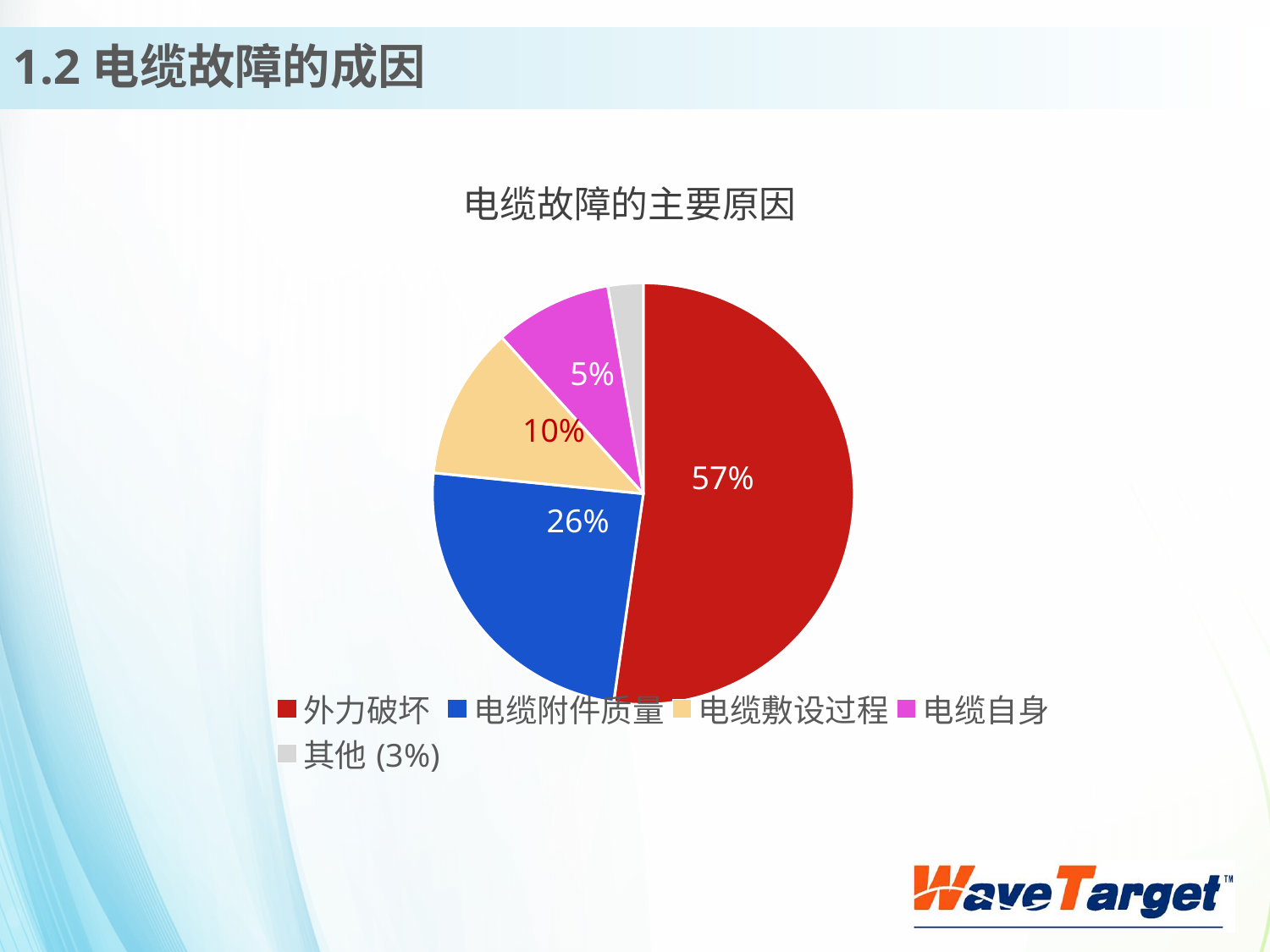
Which category has the largest slice of the pie? 外力破坏 What is the value shown for 电缆敷设过程? 10% Which is larger, the share for 电缆敷设过程 or the share for 电缆自身? 电缆敷设过程 What is the value shown for 电缆自身? 5% What is the title of the chart? 电缆故障的主要原因 What is the difference between the shares of 外力破坏 and 电缆附件质量? 31% What share of the pie does 外力破坏 account for? 57% What percentage is given for 其他 in the legend? 3% Which category has the smallest slice of the pie? 其他 How many categories does the legend list? 5 What kind of chart is shown on the slide? Pie chart What is the value shown for 电缆附件质量? 26%